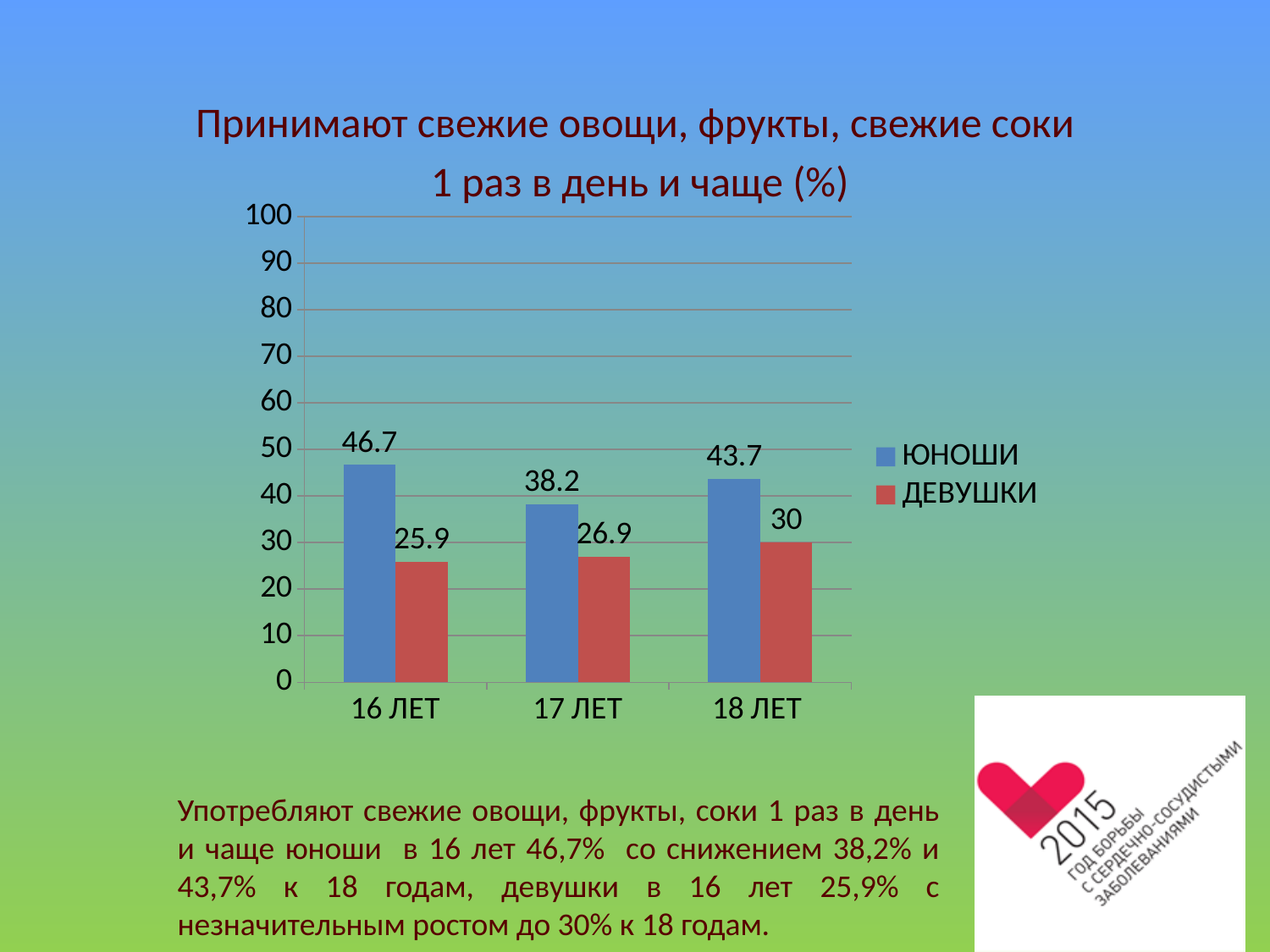
Which age group has the highest value for ЮНОШИ? 16 ЛЕТ Which age group has the lowest value for ДЕВУШКИ? 16 ЛЕТ What kind of chart is shown on the slide? bar chart What is the value for ДЕВУШКИ at 17 ЛЕТ? 26.9 How many age categories are shown on the x axis? 3 What is the value for ДЕВУШКИ at 18 ЛЕТ? 30 How many series does the legend list? 2 What is the difference between the ЮНОШИ and ДЕВУШКИ values at 16 ЛЕТ? 20.8 What is the value for ЮНОШИ at 16 ЛЕТ? 46.7 Which colour represents ДЕВУШКИ in the chart? red Which is larger at 17 ЛЕТ: the value for ЮНОШИ or for ДЕВУШКИ? ЮНОШИ Is the value for ЮНОШИ at 18 ЛЕТ greater or less than 40? greater